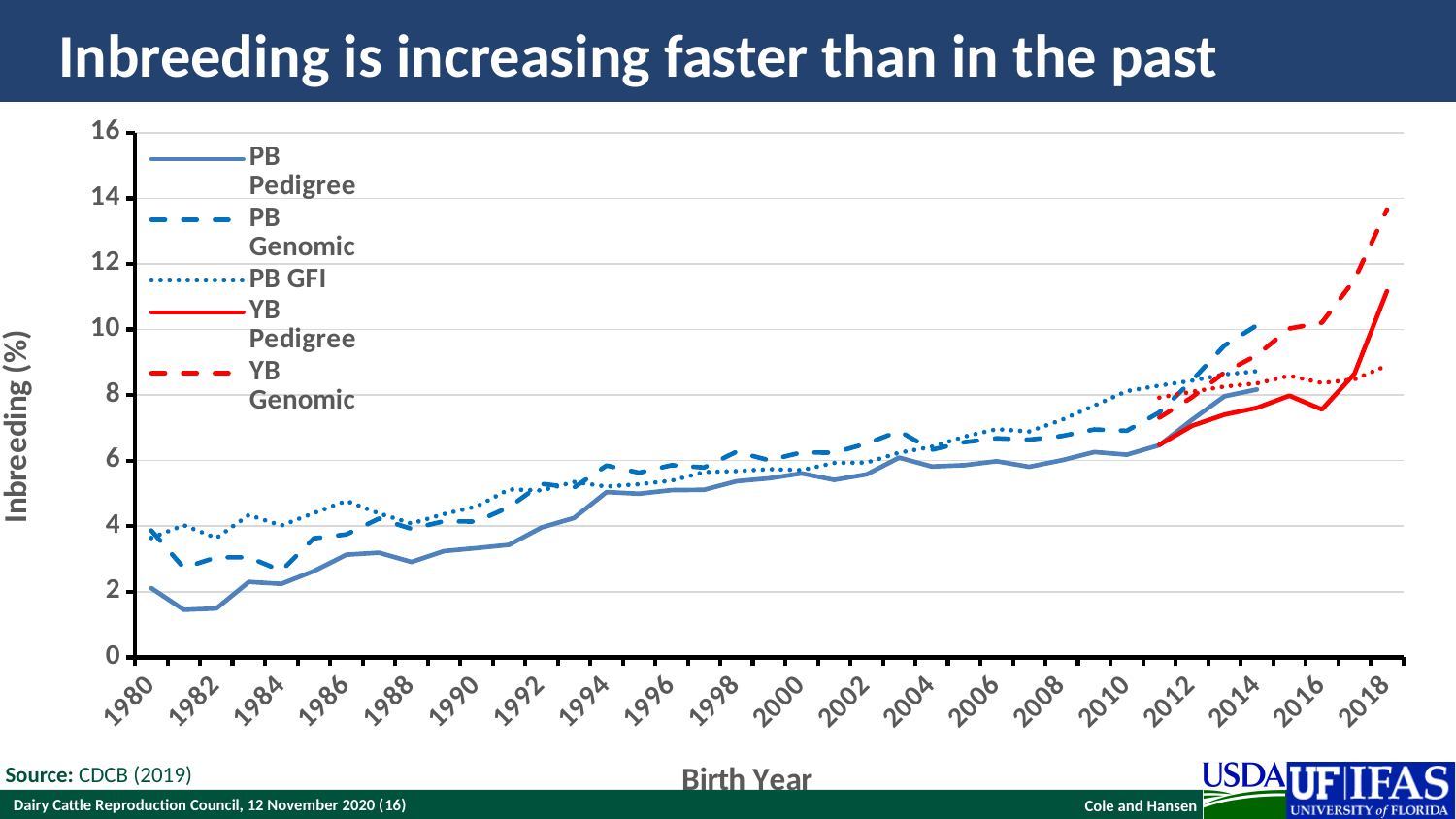
What kind of chart is shown on the slide? line chart In 1980, which is higher: PB GFI or PB Pedigree? PB GFI How many series does the legend list? 5 Is the value for PB Pedigree in 1980 greater or less than 4? less What is the label on the vertical axis? Inbreeding (%) Does the PB Pedigree series rise or fall from 1980 to 2018? rise Is the value for YB Pedigree in 2016 greater or less than 10? less Which series reaches the highest value on the chart? YB Genomic Is the value for YB Genomic in 2018 greater or less than 12? greater In 2018, which is higher: YB Genomic or YB Pedigree? YB Genomic What is the title of the chart? Inbreeding is increasing faster than in the past